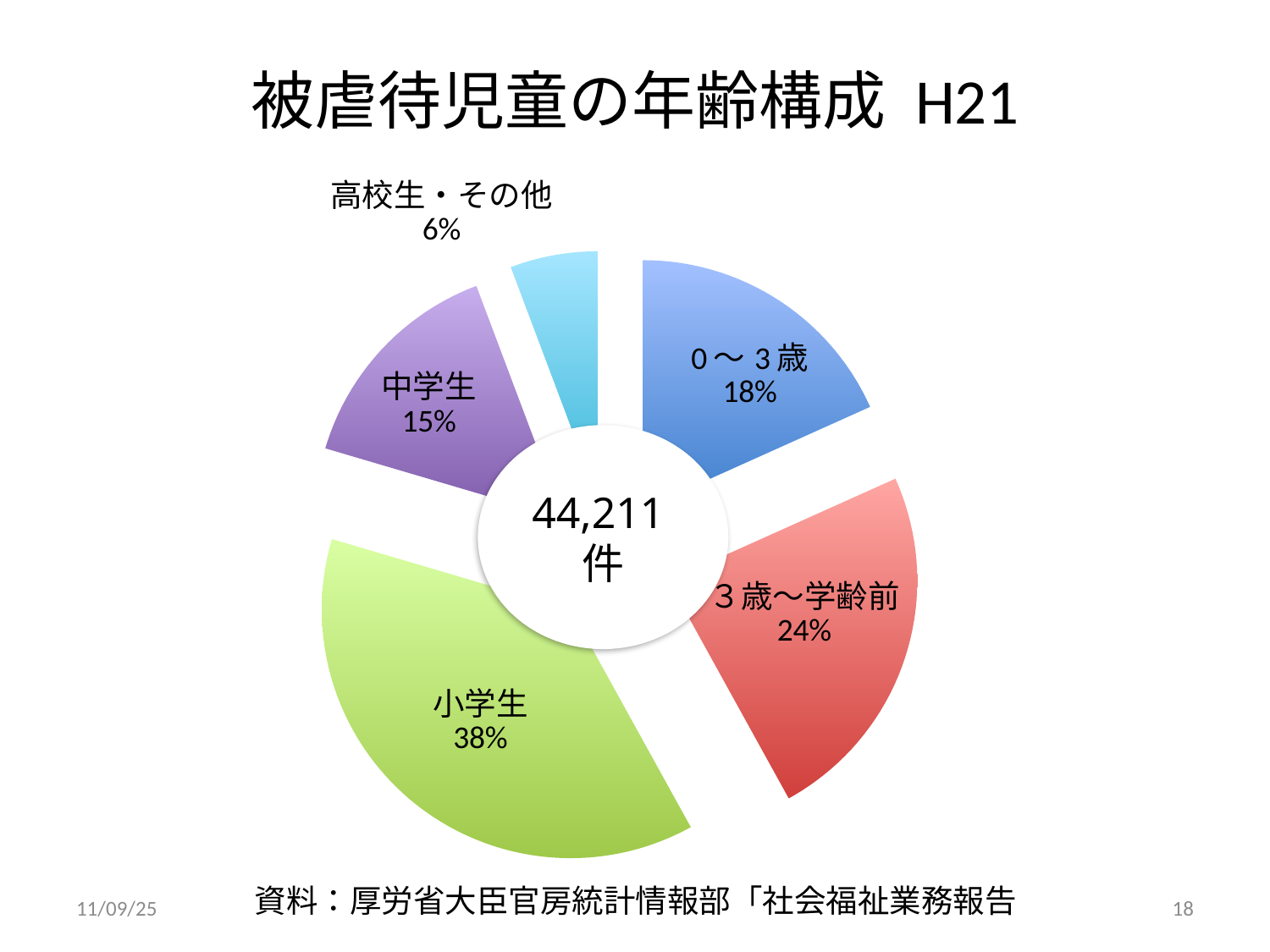
What share of the pie does 3歳～学齢前 represent? 24% What is the difference in percentage points between 小学生 and 3歳～学齢前? 14 What total number of cases is shown in the centre of the pie chart? 44,211件 Which category has the smallest share of the pie? 高校生・その他 What share of the pie does 中学生 represent? 15% What share of the pie does 高校生・その他 represent? 6% How many categories are shown in the pie chart? 5 Which is larger, the share for 0～3歳 or the share for 中学生? 0～3歳 What kind of chart is shown on the slide? pie chart Which category has the largest share of the pie? 小学生